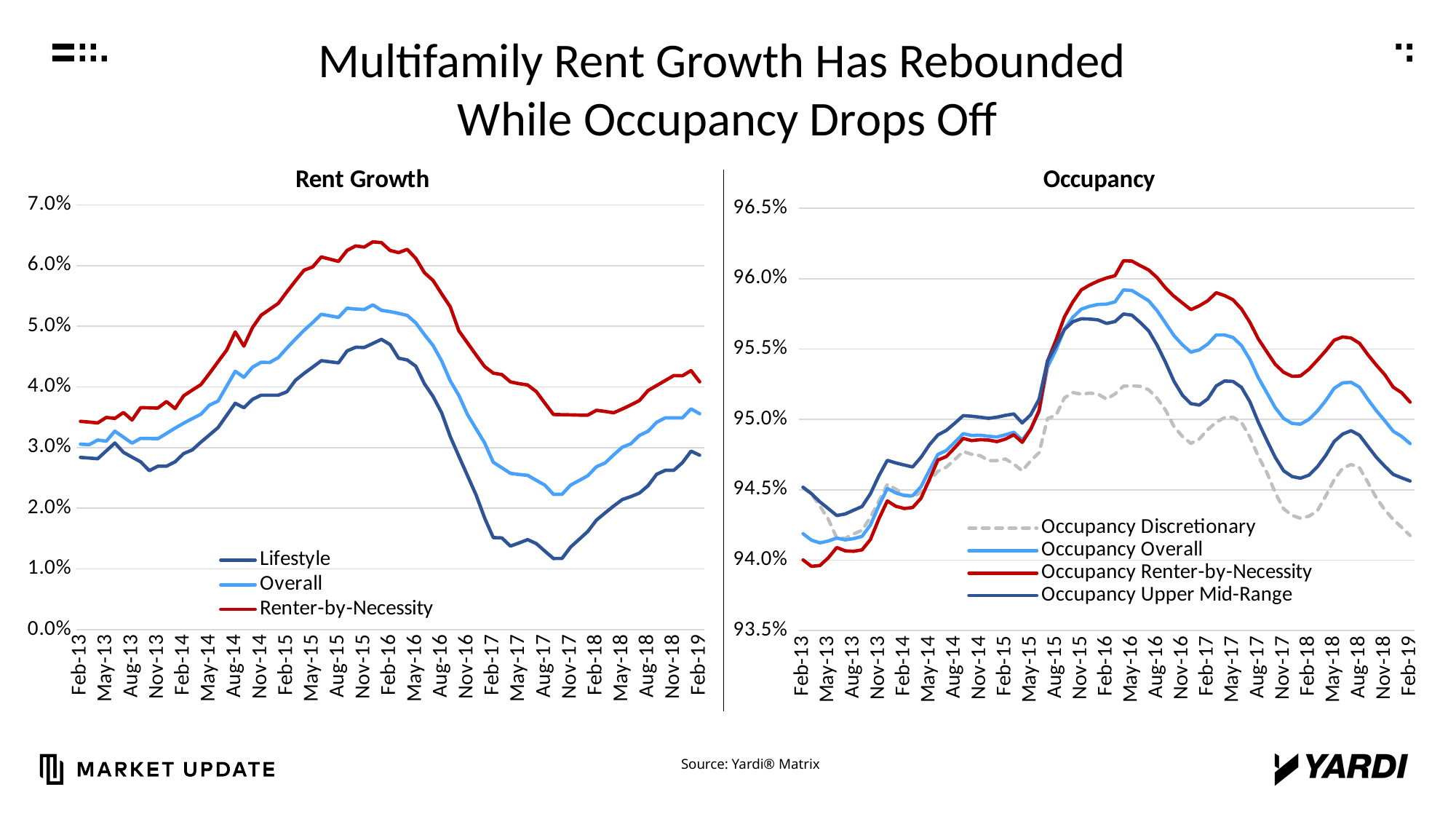
What kind of chart is the Rent Growth chart? line chart In the Occupancy chart, which series is higher at Feb-19, Occupancy Renter-by-Necessity or Occupancy Discretionary? Occupancy Renter-by-Necessity In the Rent Growth chart, which series is higher at Feb-16, Renter-by-Necessity or Lifestyle? Renter-by-Necessity In the Occupancy chart, is the peak value for Occupancy Renter-by-Necessity greater or less than 96.0%? greater How many series does the legend of the Occupancy chart list? 4 In the Rent Growth chart, does the Lifestyle series rise or fall between Feb-16 and Nov-17? fall In the Rent Growth chart, is the value for Lifestyle at Nov-17 greater or less than 2.0%? less How many series does the legend of the Rent Growth chart list? 3 In the Occupancy chart, is the value for Occupancy Discretionary at Feb-19 greater or less than 94.5%? less In the Occupancy chart, which series is drawn as a dashed line? Occupancy Discretionary